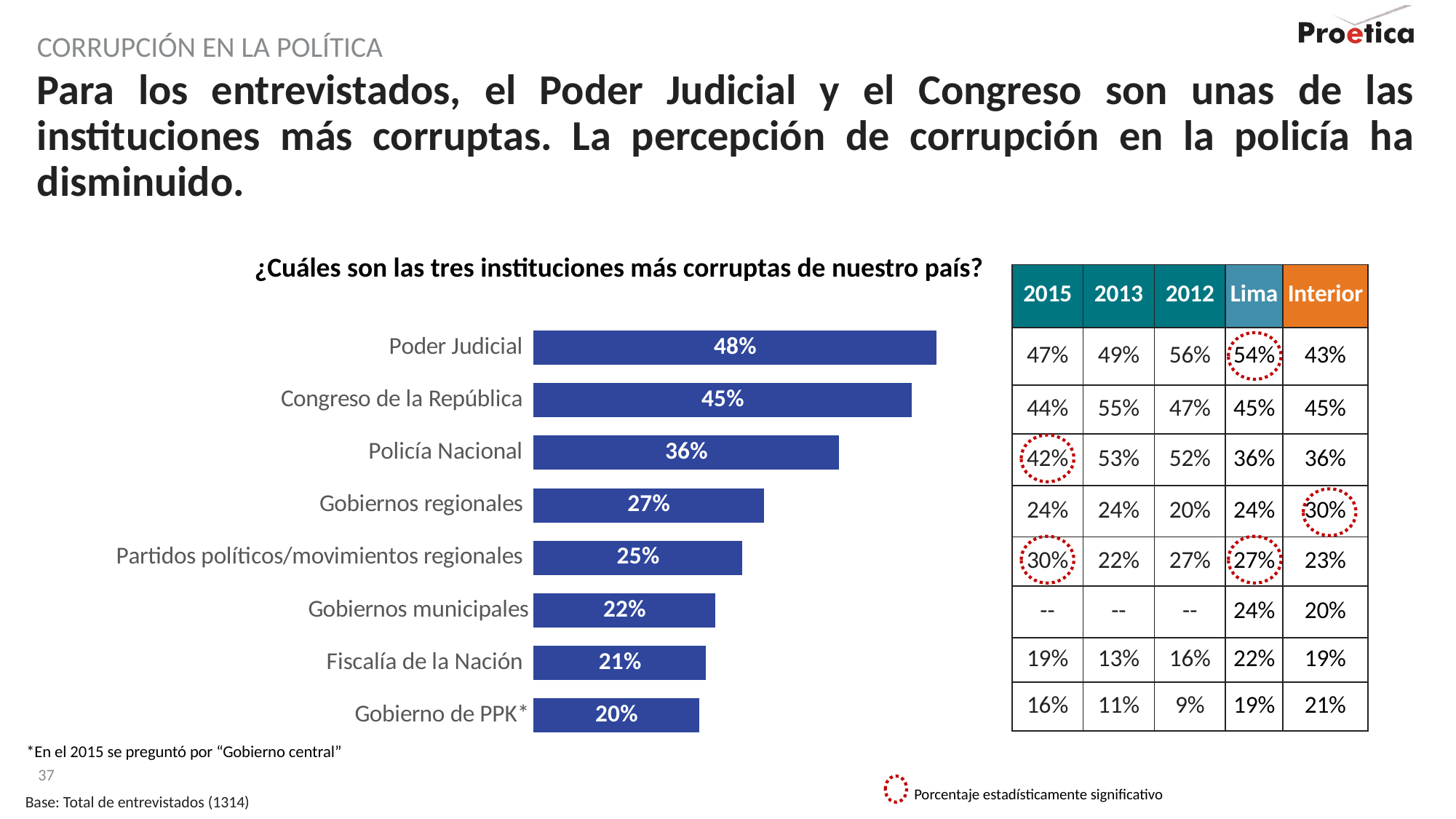
Which has a larger value in the bar chart, Gobiernos municipales or Fiscalía de la Nación? Gobiernos municipales Which institution has the highest value in the bar chart? Poder Judicial What is the difference between the values for Poder Judicial and Congreso de la República? 3% Which institution has the lowest value in the bar chart? Gobierno de PPK* What is the value shown for Policía Nacional in the bar chart? 36% What question is shown as the title of the bar chart? ¿Cuáles son las tres instituciones más corruptas de nuestro país? How many institutions are shown in the bar chart? 8 What is the difference between the values for Policía Nacional and Gobiernos regionales? 9% What kind of chart is used to show the institutions perceived as most corrupt? Bar chart Do the values in the bar chart rise or fall from the top bar to the bottom bar? Fall What is the value shown for Gobierno de PPK* in the bar chart? 20% What percentage of respondents named Poder Judicial as one of the three most corrupt institutions? 48%